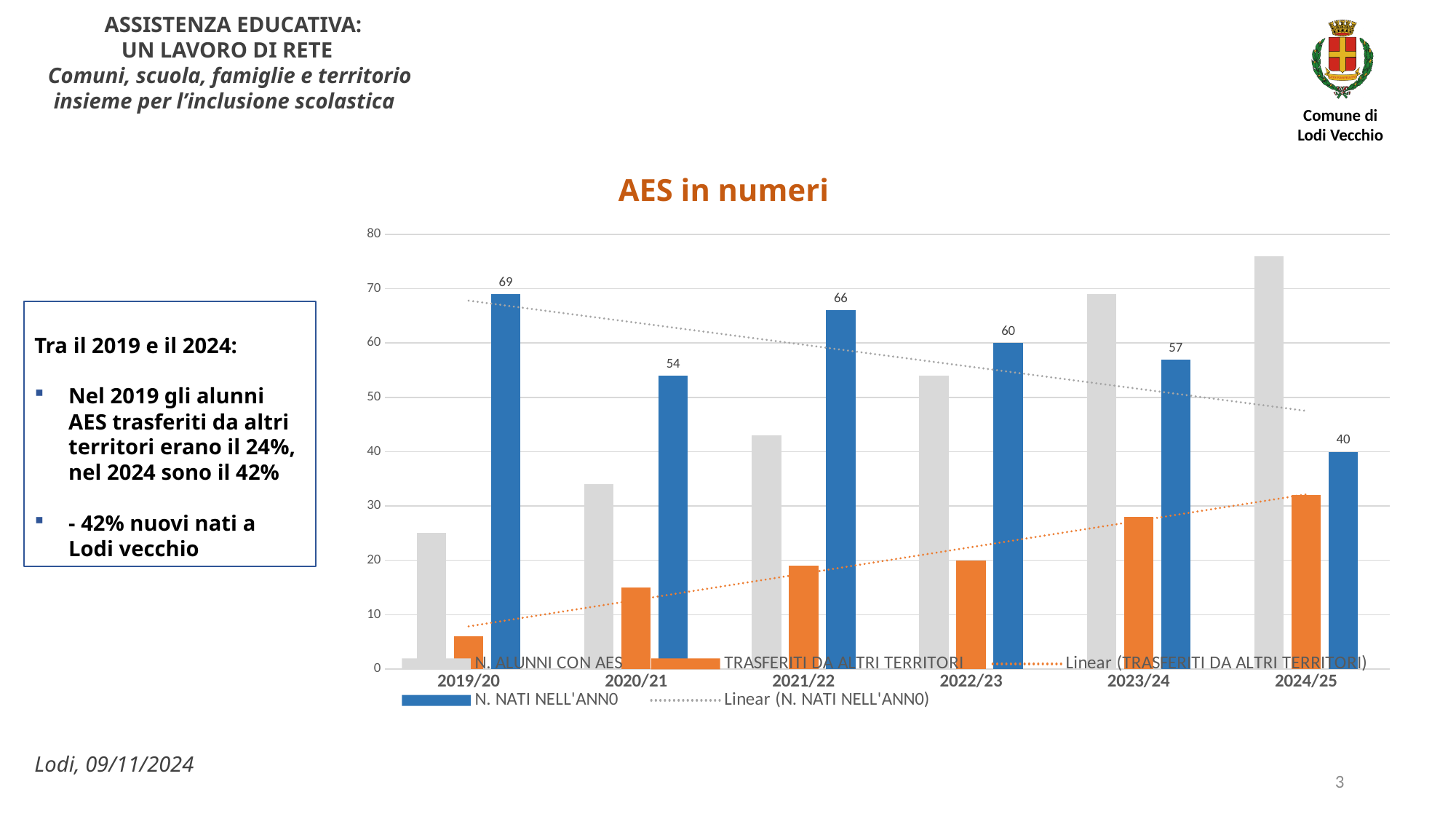
What is the difference between N. NATI NELL'ANN0 in 2019/20 and in 2024/25? 29 What is the value of N. NATI NELL'ANN0 for 2019/20? 69 What is the value of N. NATI NELL'ANN0 for 2024/25? 40 Which year has a larger N. NATI NELL'ANN0 value, 2021/22 or 2022/23? 2021/22 In which school year is N. NATI NELL'ANN0 highest? 2019/20 In which school year is N. NATI NELL'ANN0 lowest? 2024/25 Is the value for N. ALUNNI CON AES in 2024/25 greater or less than 70? greater How many entries does the legend list? 5 What kind of chart is shown on the slide? bar chart Is the value for TRASFERITI DA ALTRI TERRITORI in 2019/20 greater or less than 10? less Do the values for N. ALUNNI CON AES rise or fall from 2019/20 to 2024/25? rise How many school years are shown on the x axis? 6